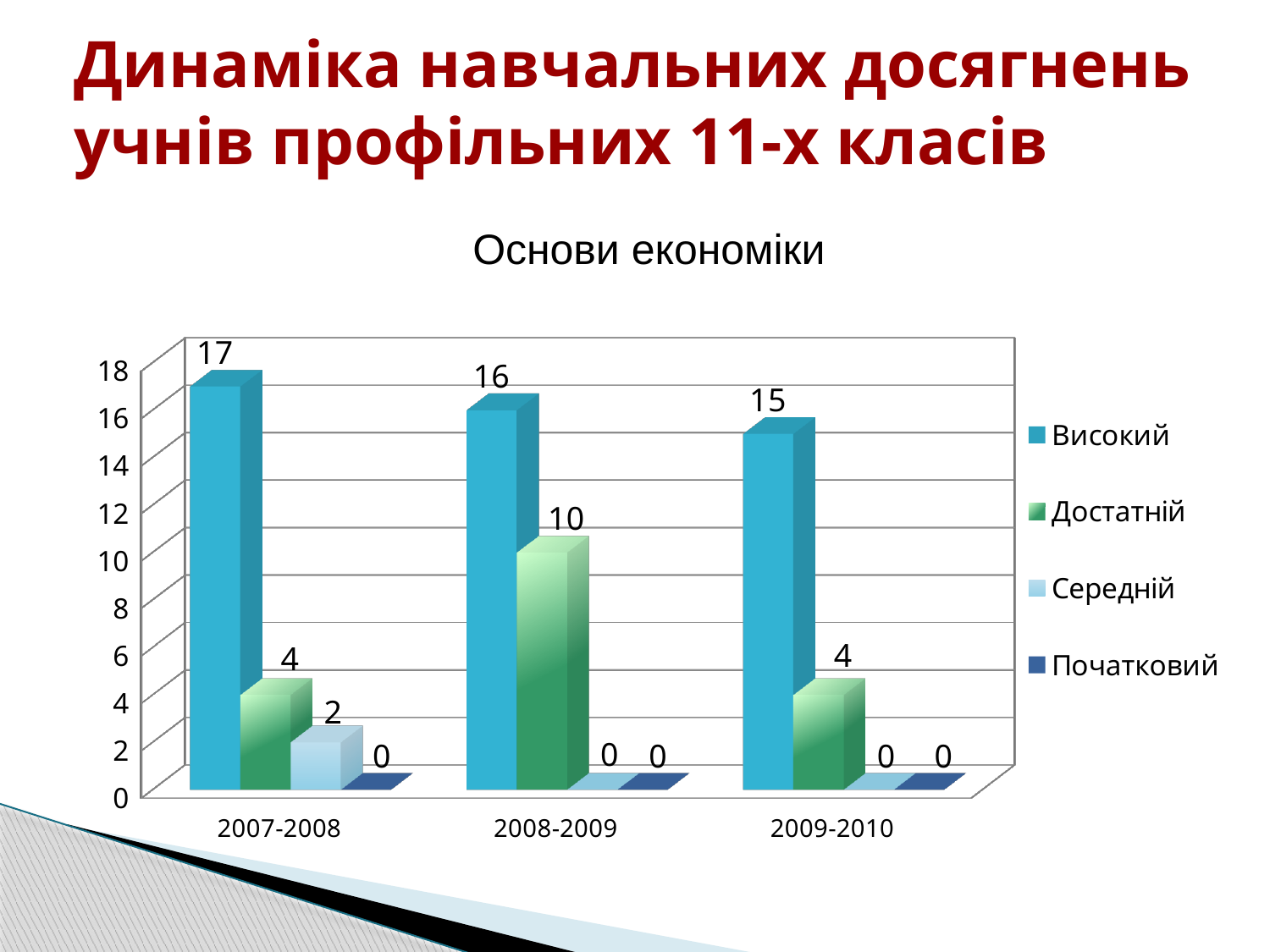
How many series does the legend list? 4 What is the difference between the Високий and Достатній values in 2008-2009? 6 What is the value for Середній in 2007-2008? 2 What kind of chart is shown? bar chart What is the value for Початковий in 2009-2010? 0 Which is larger in 2009-2010: Високий or Достатній? Високий What is the value for Достатній in 2008-2009? 10 In which year is the Високий value the lowest? 2009-2010 What is the value for Високий in 2007-2008? 17 How many year categories are shown on the x axis? 3 In which year is the Високий value the highest? 2007-2008 Does the Високий value rise or fall from 2007-2008 to 2009-2010? fall